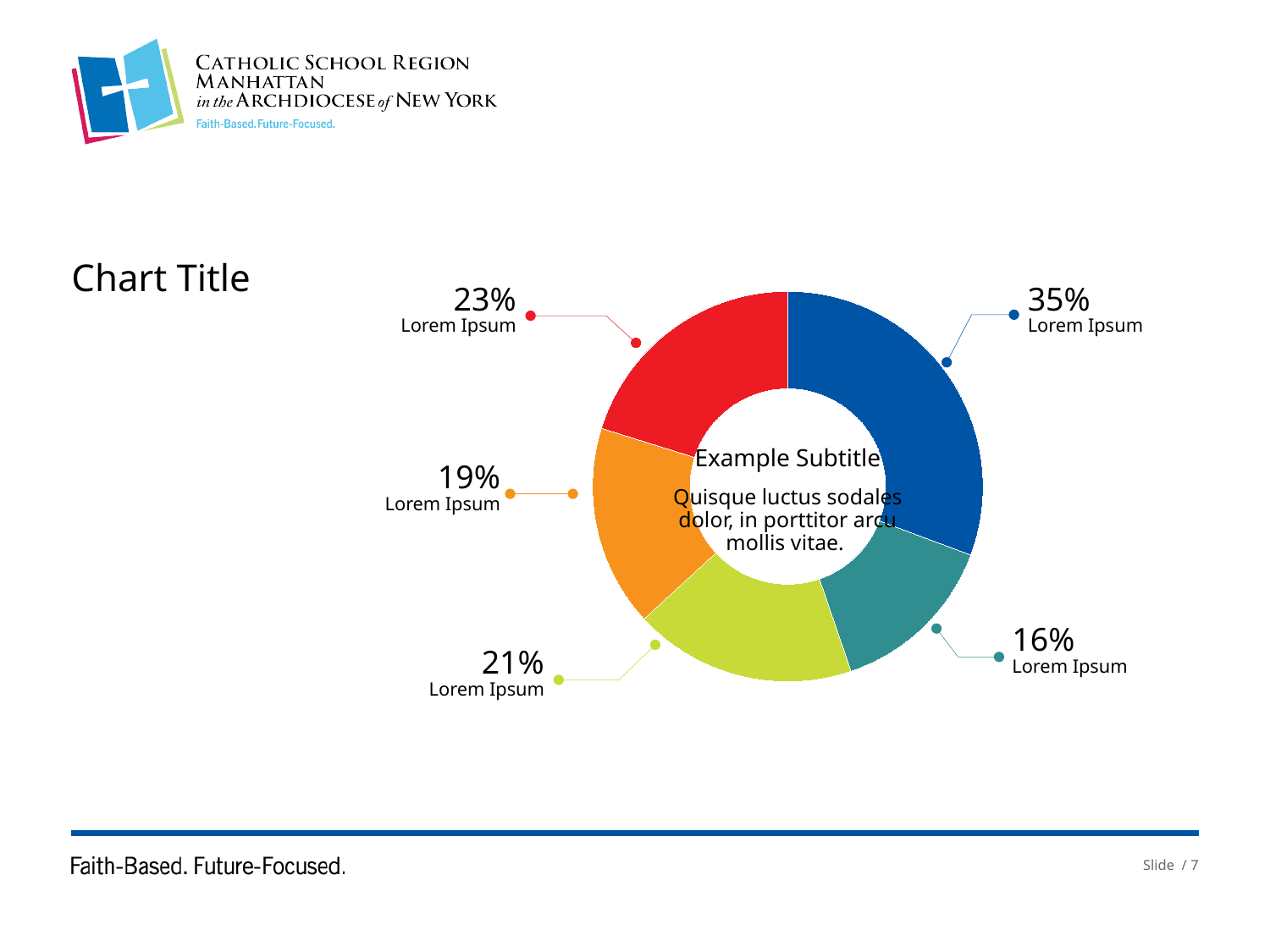
What percentage is shown for the red slice? 23% Which is larger, the red slice or the light green slice? The red slice What text appears in the centre of the donut chart as the subtitle? Example Subtitle What is the difference between the dark blue slice and the teal slice? 19% Which slice has the largest percentage? The dark blue slice (35%) What percentage is shown for the teal slice? 16% Which slice has the smallest percentage? The teal slice (16%) How many slices does the donut chart have? 5 What percentage is shown for the dark blue slice? 35% What percentage is shown for the light green slice? 21% What percentage is shown for the orange slice? 19% What kind of chart is shown on the slide? Pie chart (donut)